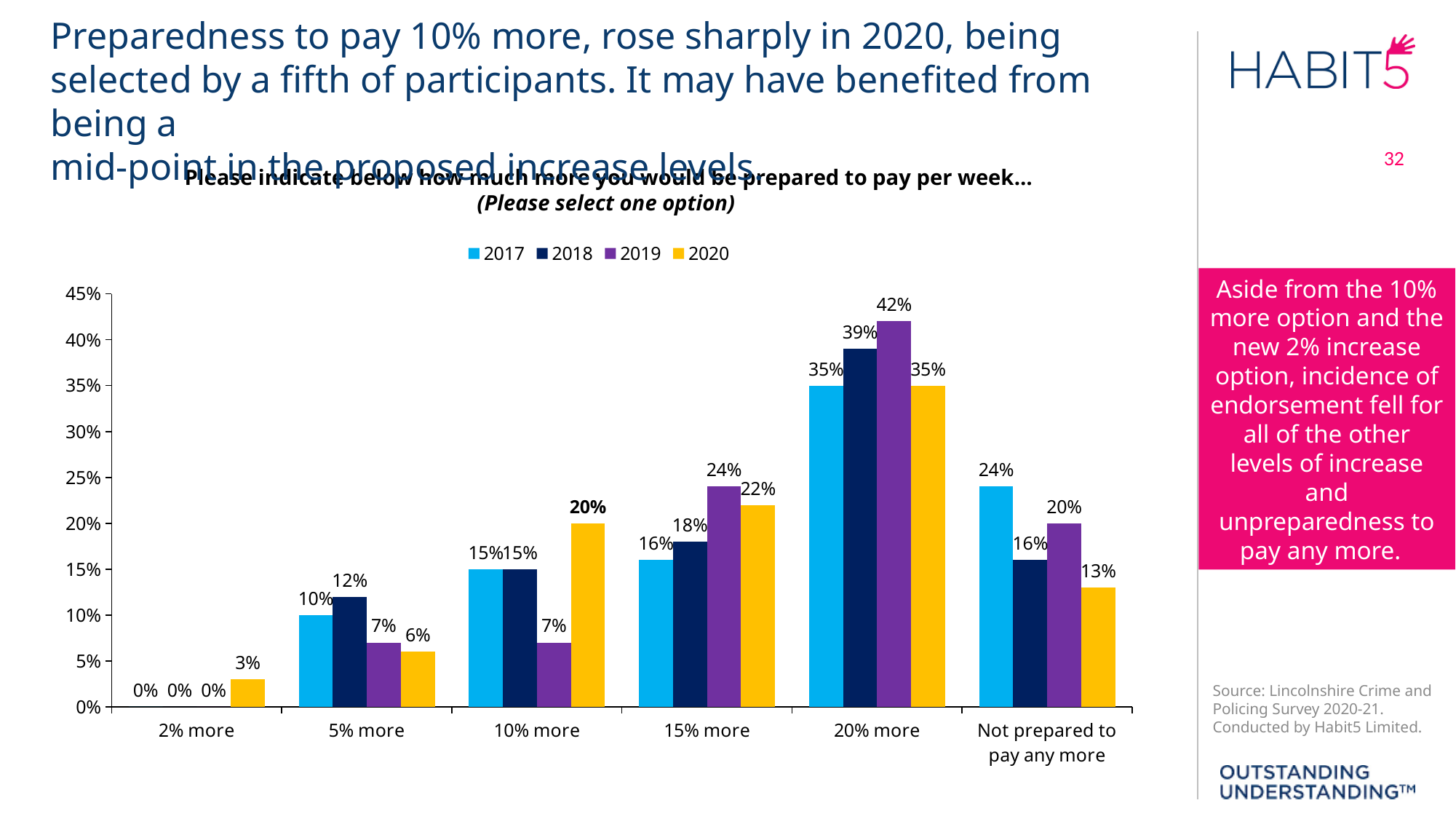
What is the 2020 value for the '10% more' category? 20% What is the 2017 value for 'Not prepared to pay any more'? 24% Which series is shown in yellow in the legend? 2020 How many series does the legend list? 4 Which category has the lowest 2019 value? 2% more What is the 2019 value for the '20% more' category? 42% How many categories are shown on the x axis? 6 What kind of chart is shown on the slide? Bar chart Which is larger for the '15% more' category: the 2019 value or the 2020 value? 2019 Which category has the highest 2018 value? 20% more What is the 2020 value for the '2% more' category? 3% What is the difference between the 2019 and 2020 values for 'Not prepared to pay any more'? 7%